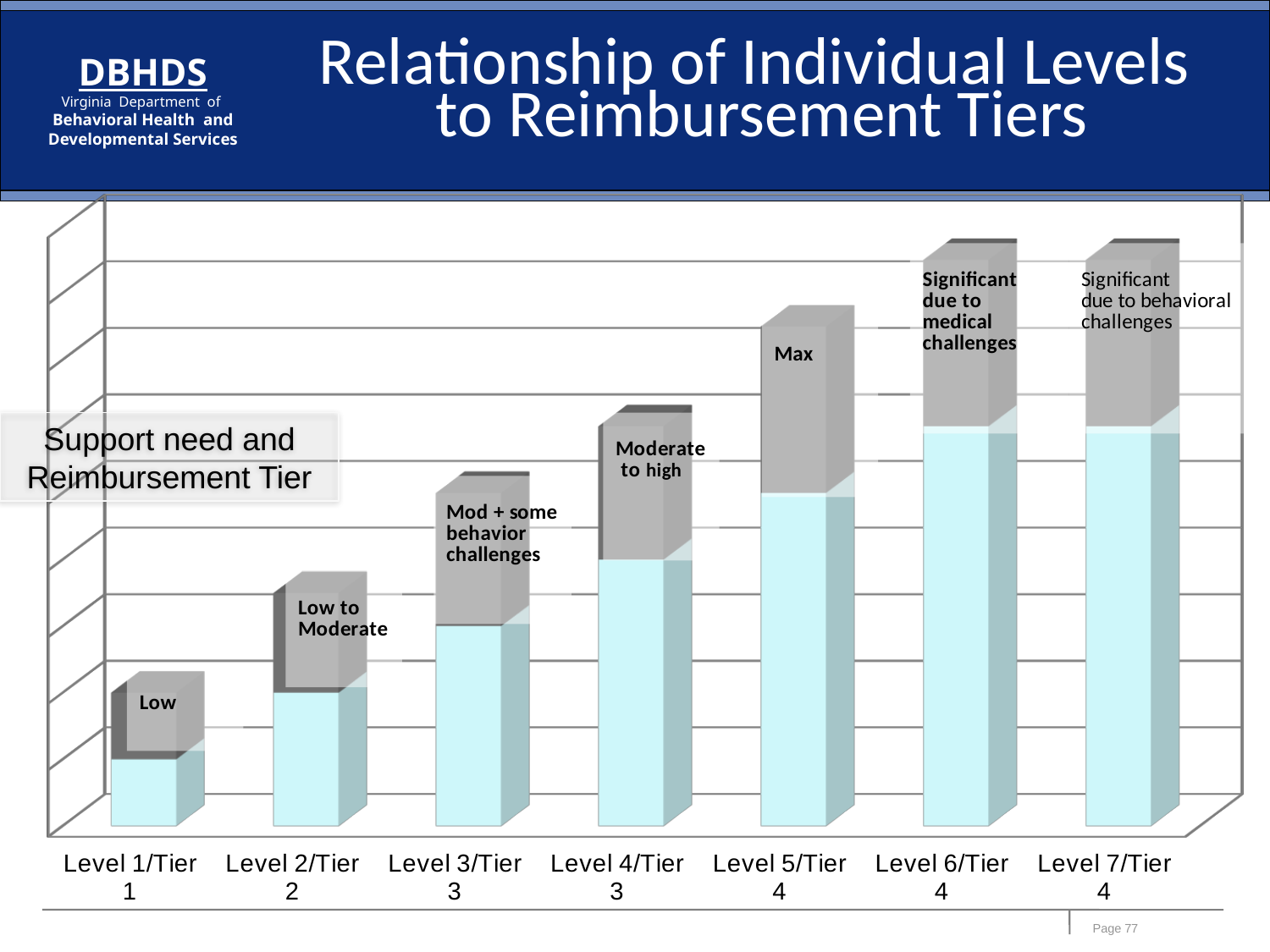
What support-need label is printed on the bar for Level 2/Tier 2? Low to Moderate How many categories are shown along the x axis of the chart? 7 Which bar is shorter, Level 6/Tier 4 or Level 1/Tier 1? Level 1/Tier 1 What kind of chart is shown on the slide? Stacked bar chart Which reimbursement tier is paired with Level 7 on the x axis? Tier 4 What is the title of the chart on the slide? Relationship of Individual Levels to Reimbursement Tiers Which category has the lowest bar in the chart? Level 1/Tier 1 Which bar is taller, Level 5/Tier 4 or Level 2/Tier 2? Level 5/Tier 4 Do the bar heights rise or fall from Level 1/Tier 1 to Level 7/Tier 4? Rise What support-need label is printed on the bar for Level 5/Tier 4? Max Which bar is taller, Level 3/Tier 3 or Level 4/Tier 3? Level 4/Tier 3 What support-need label is printed on the bar for Level 6/Tier 4? Significant due to medical challenges